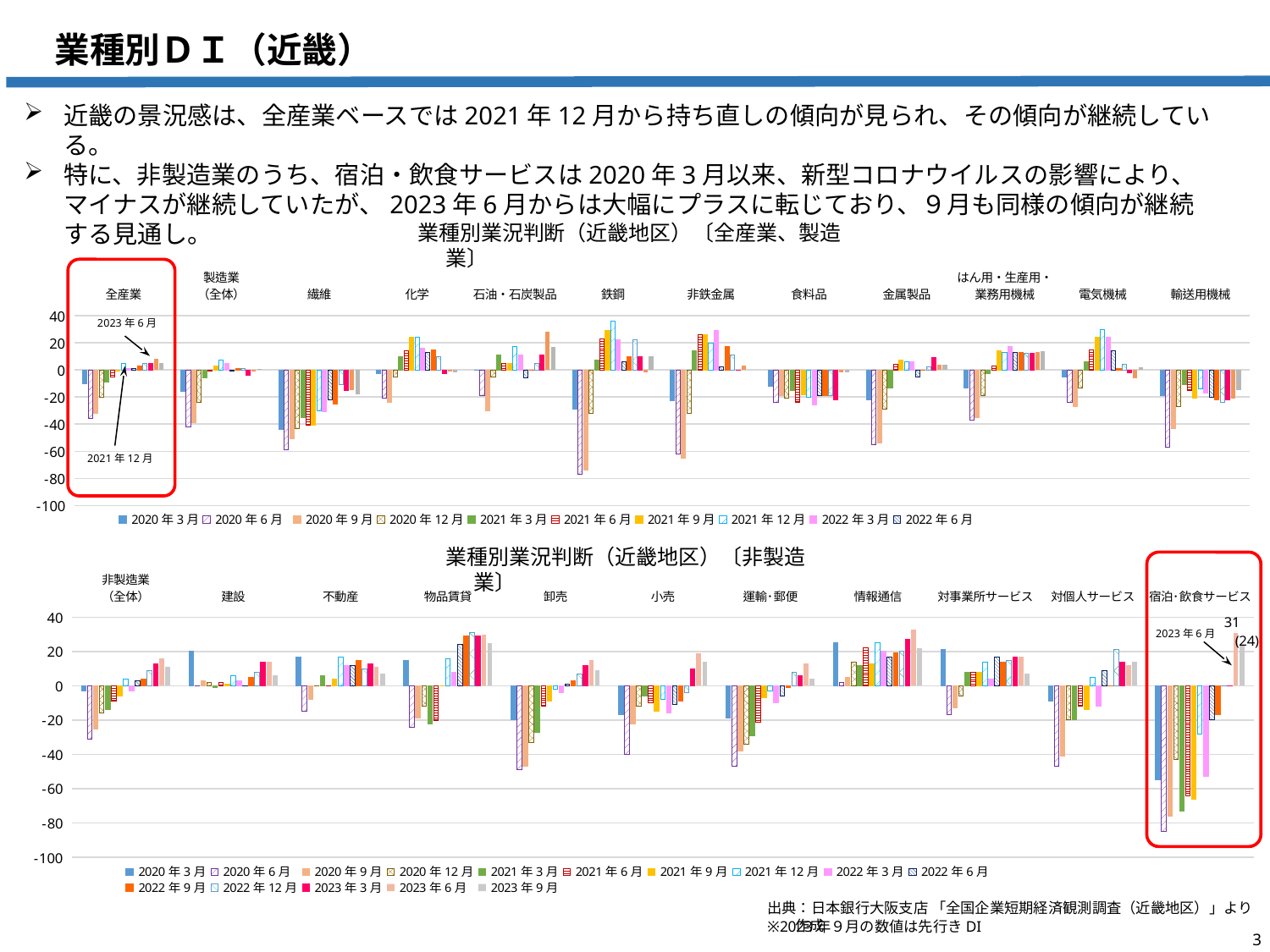
In the bottom chart (非製造業), is the value for 情報通信 in 2023年6月 greater or less than 20? greater In the top chart (全産業、製造業), is the value for 鉄鋼 in 2020年6月 greater or less than -60? less In the top chart (全産業、製造業), which industry category has the lowest bar? 鉄鋼 In the bottom chart (非製造業), how many industry categories are shown along the x axis? 11 In the top chart (全産業、製造業), how many industry categories are shown along the x axis? 12 What kind of chart is the top chart titled 業種別業況判断（近畿地区）〔全産業、製造業〕? bar chart What is the title of the bottom chart on the slide? 業種別業況判断（近畿地区）〔非製造業〕 In the bottom chart (非製造業), how many series does the legend list? 15 In the bottom chart (非製造業), which industry category has the lowest bar? 宿泊・飲食サービス In the bottom chart (非製造業), what is the value for 宿泊・飲食サービス in 2023年6月? 31 In the bottom chart (非製造業), which is larger for 宿泊・飲食サービス: the value for 2020年6月 or the value for 2023年6月? 2023年6月 In the bottom chart (非製造業), is the value for 宿泊・飲食サービス in 2020年6月 greater or less than -60? less